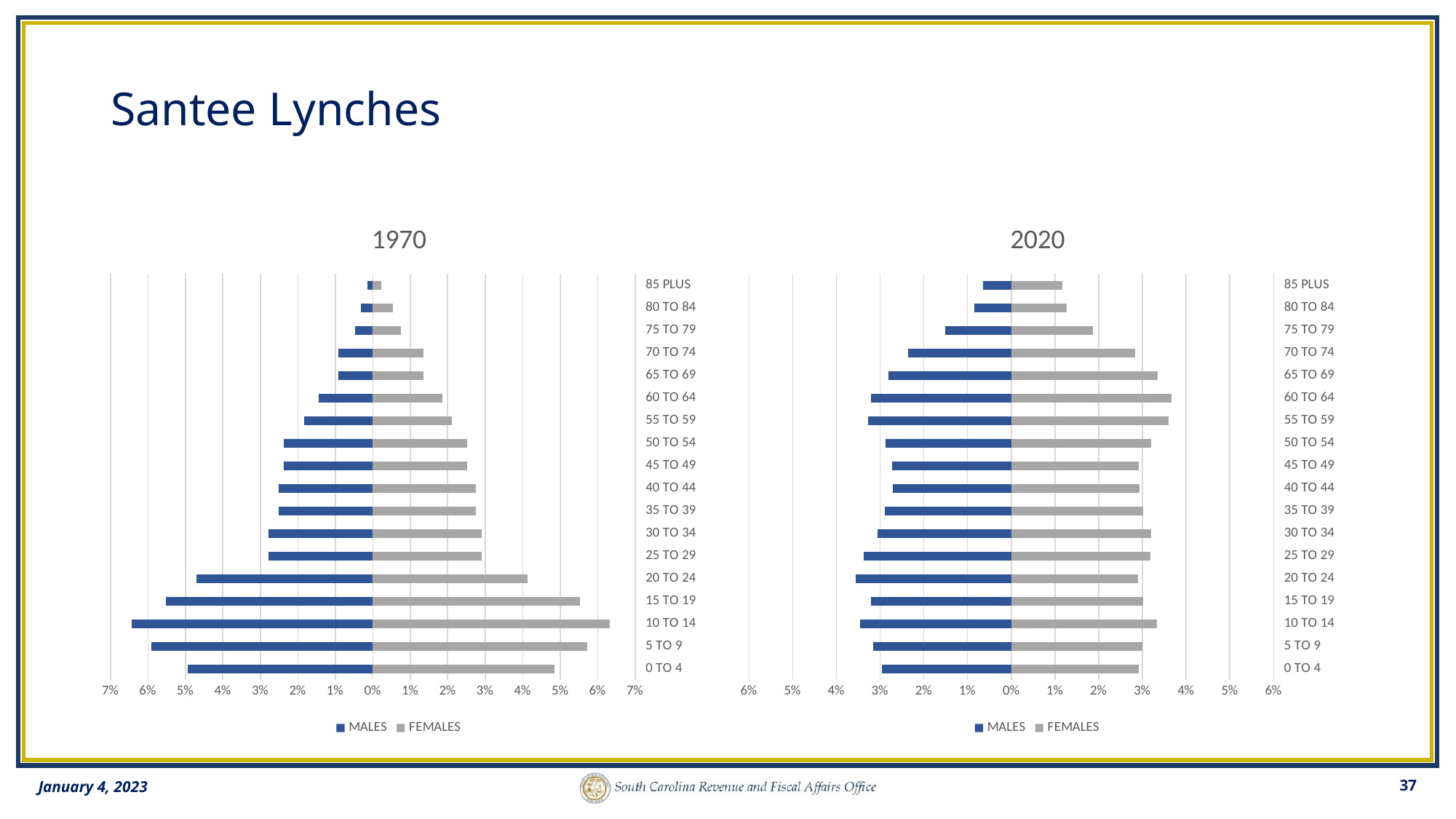
In the 1970 chart, which age group has the lowest value for MALES? 85 PLUS In the 1970 chart, which age group has the highest value for MALES? 10 TO 14 In the 1970 chart, which is larger for 20 TO 24, MALES or FEMALES? MALES In the 2020 chart, which age group has the lowest value for MALES? 85 PLUS How many series does the legend of the 2020 chart list? 2 What kind of chart is the 1970 chart? bar chart How many age groups are shown on the 1970 chart? 18 In the 1970 chart, is the FEMALES value for 85 PLUS greater or less than 1%? less In the 2020 chart, is the FEMALES value for 60 TO 64 greater or less than 3%? greater In the 1970 chart, is the MALES value for 10 TO 14 greater or less than 6%? greater In the 2020 chart, which is larger for 85 PLUS, MALES or FEMALES? FEMALES